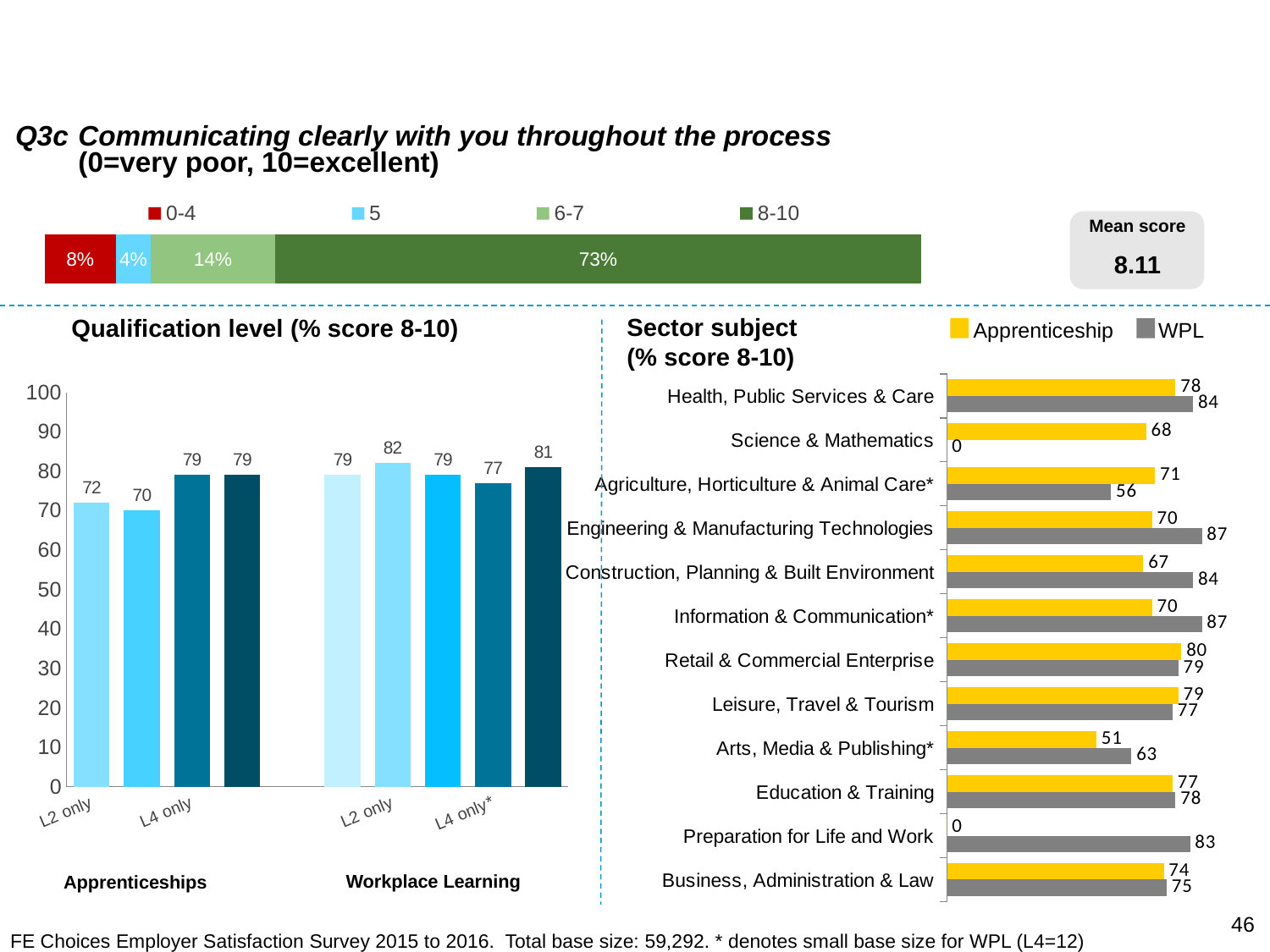
In the Sector subject chart, what is the WPL value for Health, Public Services & Care? 84 How many series does the legend of the Sector subject chart list? 2 In the Qualification level chart, what is the highest value shown? 82 In the Sector subject chart, which sector has the highest Apprenticeship value? Retail & Commercial Enterprise In the Sector subject chart, which sector has the lowest WPL value? Science & Mathematics What is the mean score shown on the slide? 8.11 What kind of chart is the Qualification level (% score 8-10) chart? Bar chart In the top stacked bar showing the score distribution, what percentage scored 8-10? 73% In the Sector subject chart, what is the Apprenticeship value for Arts, Media & Publishing*? 51 In the Sector subject chart, how many sector subjects are listed? 12 In the Sector subject chart, what is the difference between the WPL and Apprenticeship values for Engineering & Manufacturing Technologies? 17 In the top stacked bar, what percentage scored 0-4? 8%